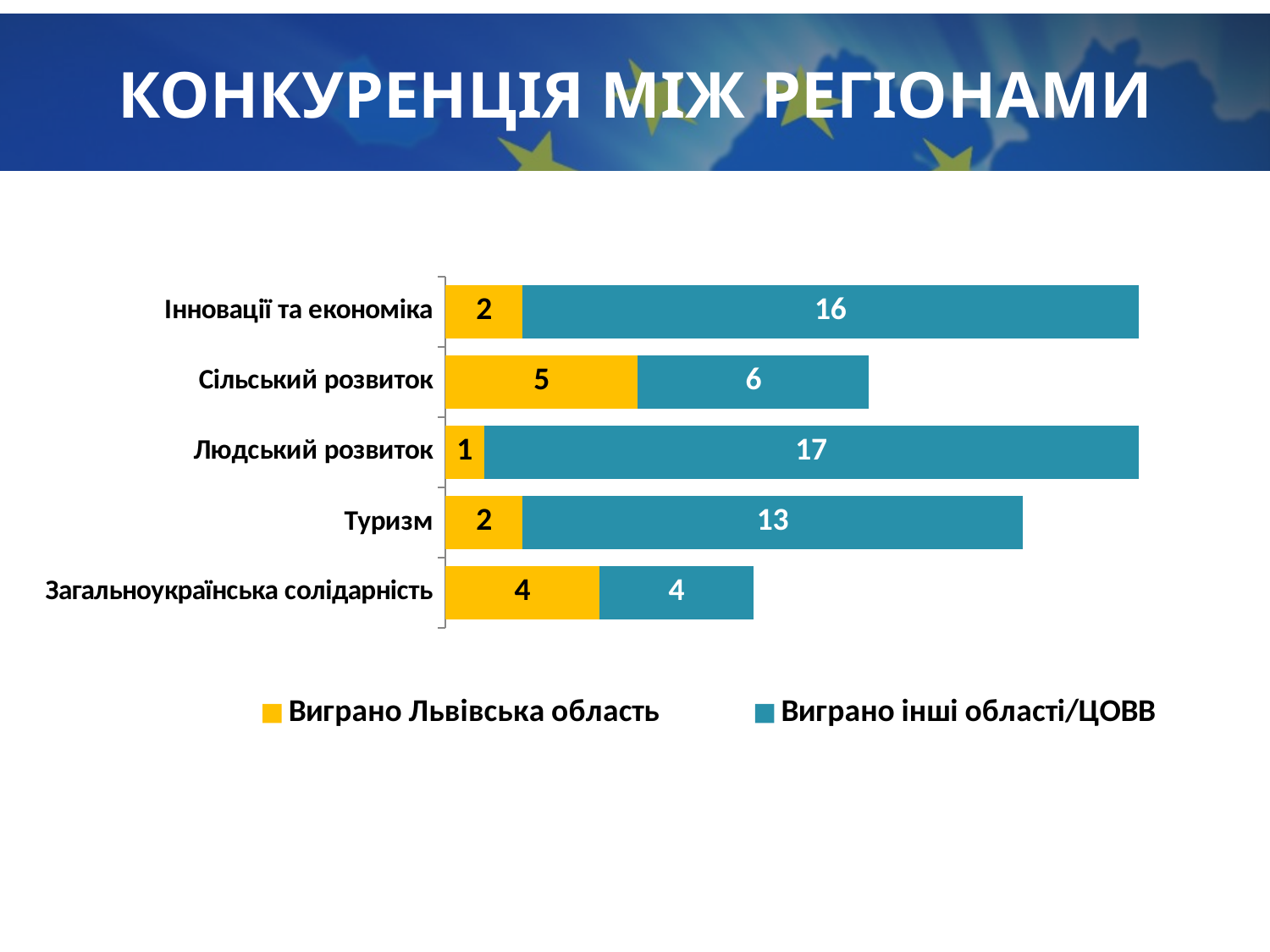
In the "Сільський розвиток" category, which series has the larger value: "Виграно Львівська область" or "Виграно інші області/ЦОВВ"? Виграно інші області/ЦОВВ What value is shown for "Виграно інші області/ЦОВВ" in the "Туризм" category? 13 What value is shown for "Виграно Львівська область" in the "Сільський розвиток" category? 5 What is the difference between the "Виграно інші області/ЦОВВ" value and the "Виграно Львівська область" value in the "Інновації та економіка" category? 14 Which category has the lowest value for "Виграно Львівська область"? Людський розвиток Which category has the highest value for "Виграно інші області/ЦОВВ"? Людський розвиток What is the total of the stacked bar for "Туризм"? 15 How many categories are shown on the chart? 5 What kind of chart is shown on the slide? Stacked bar chart What value is shown for "Виграно Львівська область" in the "Людський розвиток" category? 1 What is the total of the stacked bar for "Загальноукраїнська солідарність"? 8 How many series does the legend list? 2